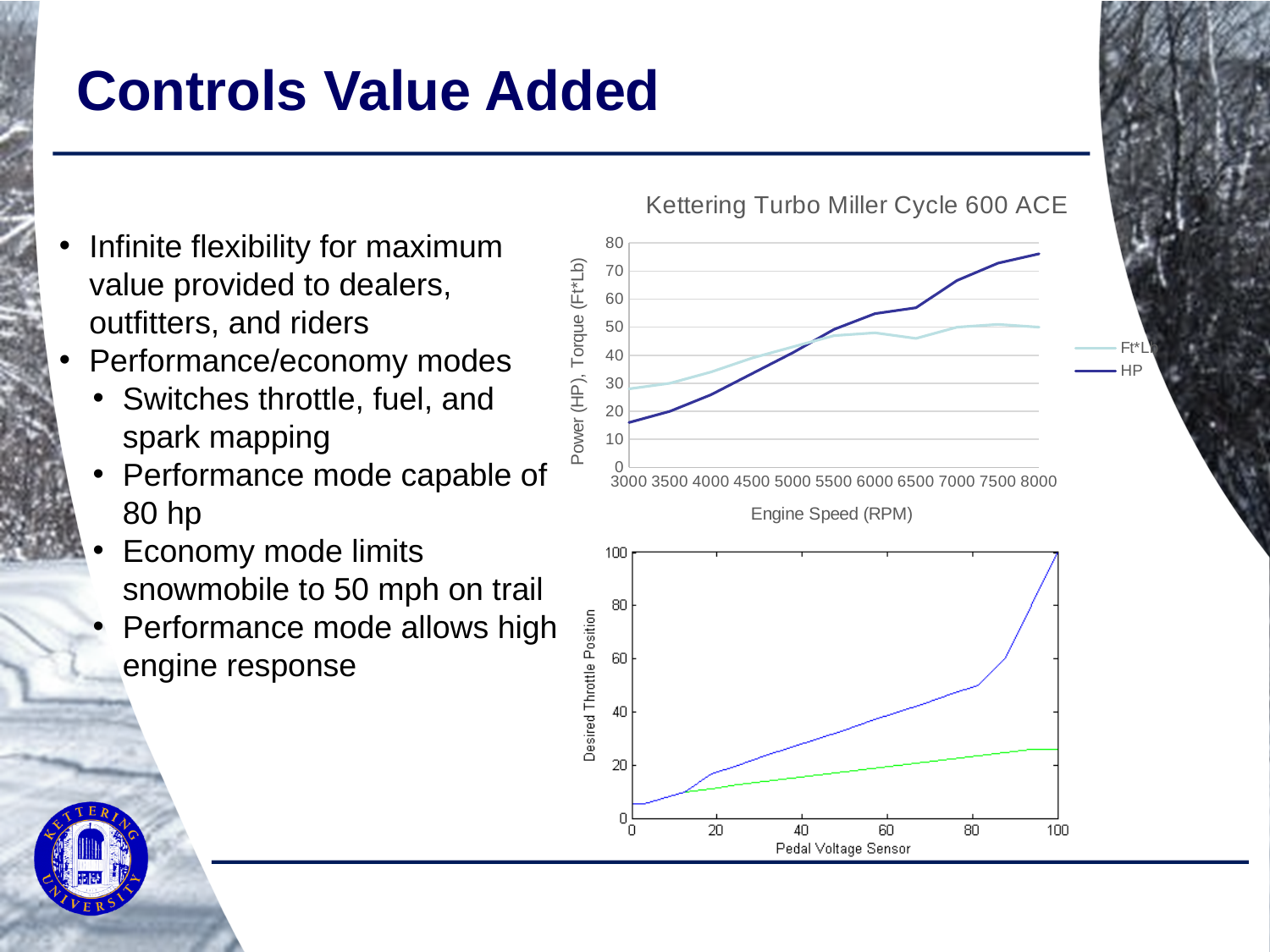
In the top chart, which series is larger at 3000 RPM, HP or Ft*Lb? Ft*Lb What is the y-axis label of the bottom chart? Desired Throttle Position In the top chart, is the HP value at 3000 RPM greater or less than 20? less What kind of chart is the top chart titled 'Kettering Turbo Miller Cycle 600 ACE'? Line chart In the top chart, which series is larger at 8000 RPM, HP or Ft*Lb? HP How many series does the legend of the top chart list? 2 What is the x-axis label of the top chart? Engine Speed (RPM) In the top chart, does the HP series rise or fall as engine speed increases from 3000 to 8000 RPM? Rise In the bottom chart, is the blue line's value at a pedal voltage sensor reading of 80 greater or less than 40? greater In the top chart, is the HP value at 8000 RPM greater or less than 70? greater In the bottom chart, does the green line rise or fall as the pedal voltage sensor increases from 0 to 100? Rise